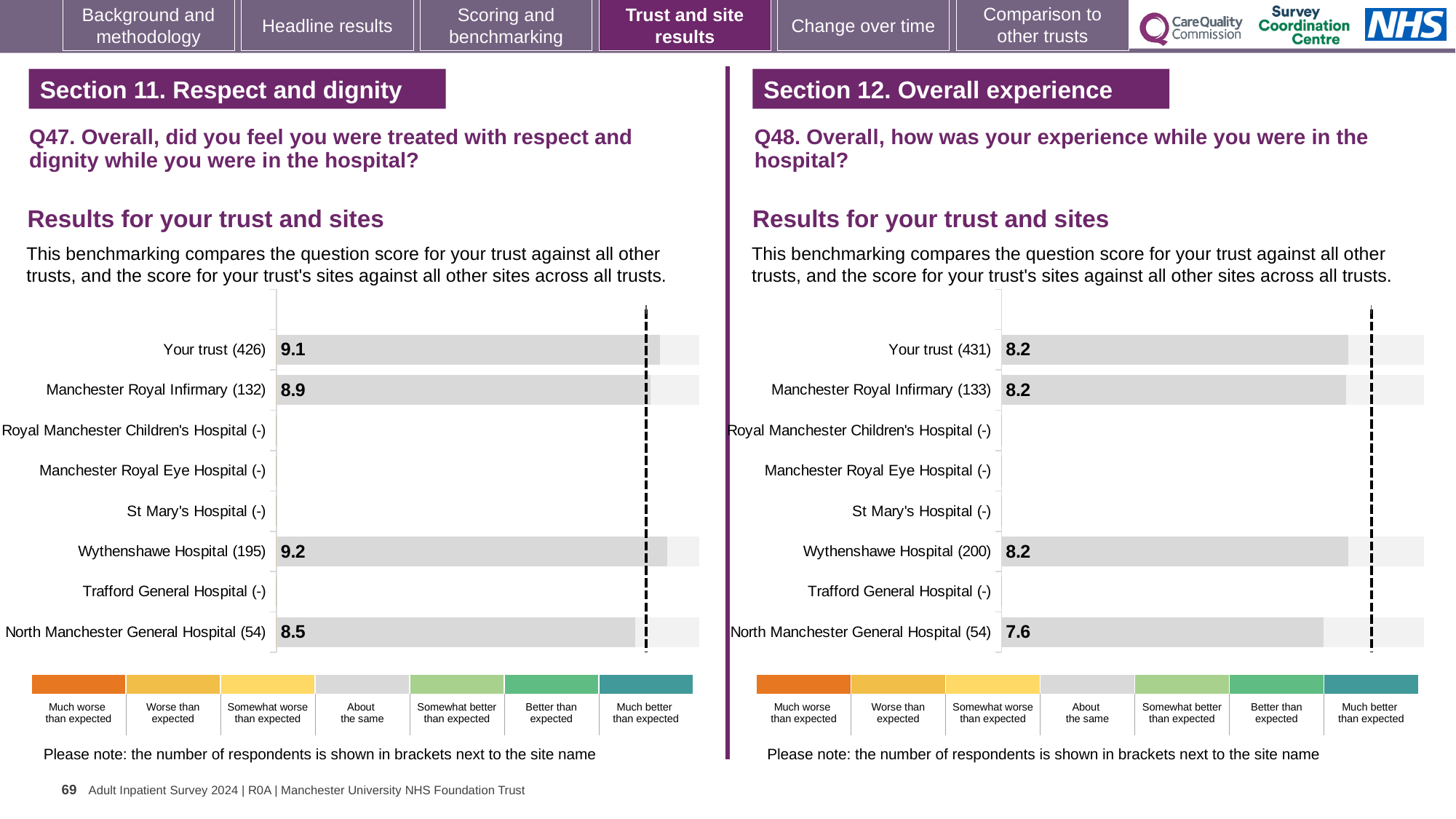
How many site rows (categories) are listed in the Q47 chart on the left? 8 In the Q47 chart on the left, which site has the lowest score? North Manchester General Hospital (54) What kind of chart is used for the Q48 results on the right? Bar chart In the Q48 chart on the right, which site has the lowest score? North Manchester General Hospital (54) In the Q47 chart on the left, which has the higher score: Your trust or Manchester Royal Infirmary? Your trust In the Q48 chart on the right, what is the difference between the scores for Your trust and North Manchester General Hospital? 0.6 In the Q48 chart on the right, what is the score for North Manchester General Hospital (54)? 7.6 In the Q47 chart on the left, what is the score for Manchester Royal Infirmary (132)? 8.9 In the Q48 chart on the right, what is the score for Wythenshawe Hospital (200)? 8.2 In the Q47 chart on the left, which site has the highest score? Wythenshawe Hospital (195) In the Q47 chart on the left, what is the score for Your trust (426)? 9.1 In the Q47 chart on the left, what is the difference between the scores for Wythenshawe Hospital and North Manchester General Hospital? 0.7